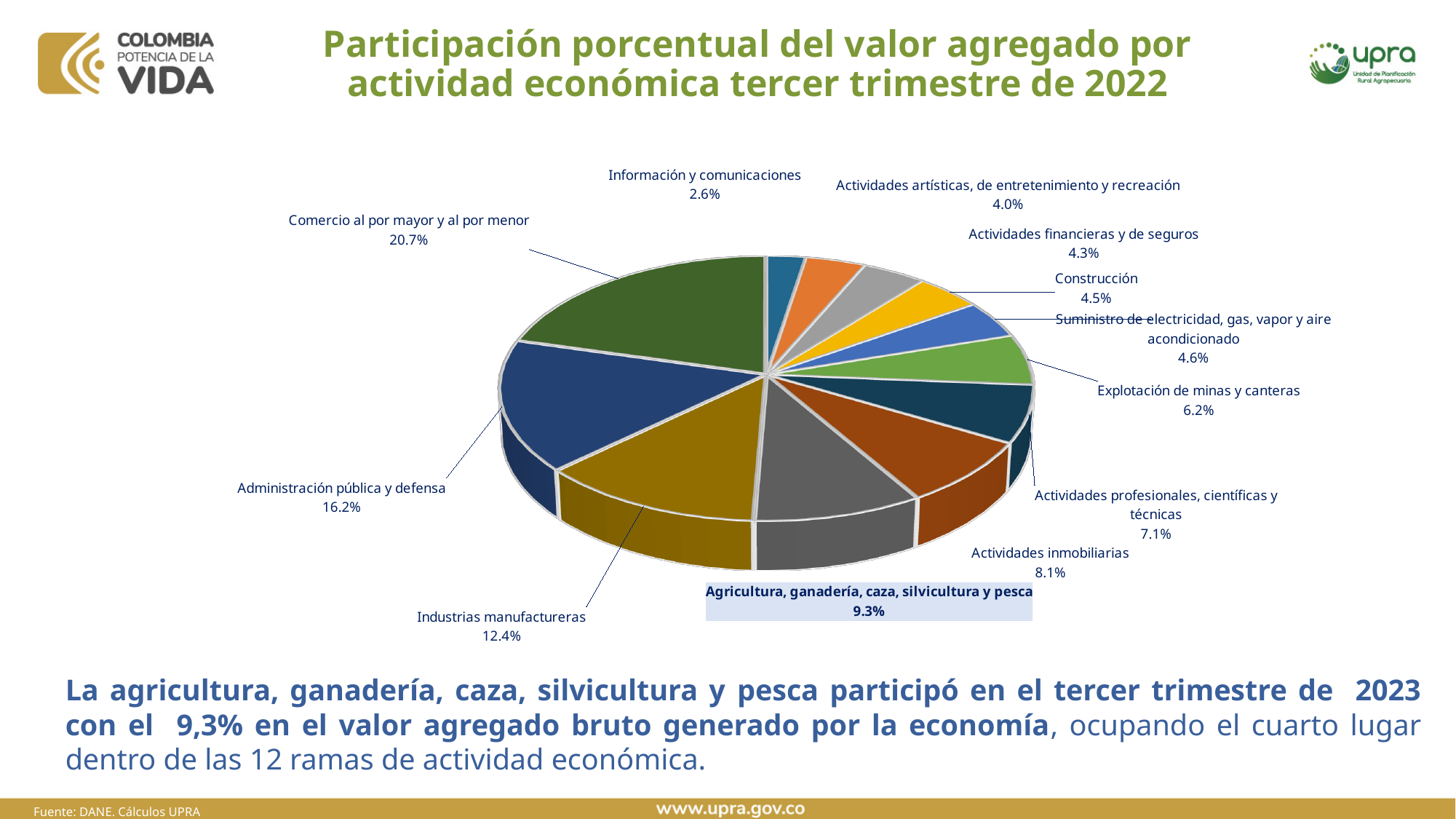
What share of the pie does Administración pública y defensa represent? 16.2% Which economic activity has the smallest share of the pie? Información y comunicaciones What kind of chart is shown on the slide? Pie chart What is the percentage share for Explotación de minas y canteras? 6.2% Which has a larger share: Industrias manufactureras or Actividades inmobiliarias? Industrias manufactureras What is the percentage share for Comercio al por mayor y al por menor? 20.7% Which economic activity has the largest share of the pie? Comercio al por mayor y al por menor What is the title of the chart on the slide? Participación porcentual del valor agregado por actividad económica tercer trimestre de 2022 What is the percentage share for Construcción? 4.5% What is the difference in percentage points between Comercio al por mayor y al por menor and Administración pública y defensa? 4.5 percentage points How many economic activities (slices) does the pie chart show? 12 What is the percentage share for Agricultura, ganadería, caza, silvicultura y pesca? 9.3%